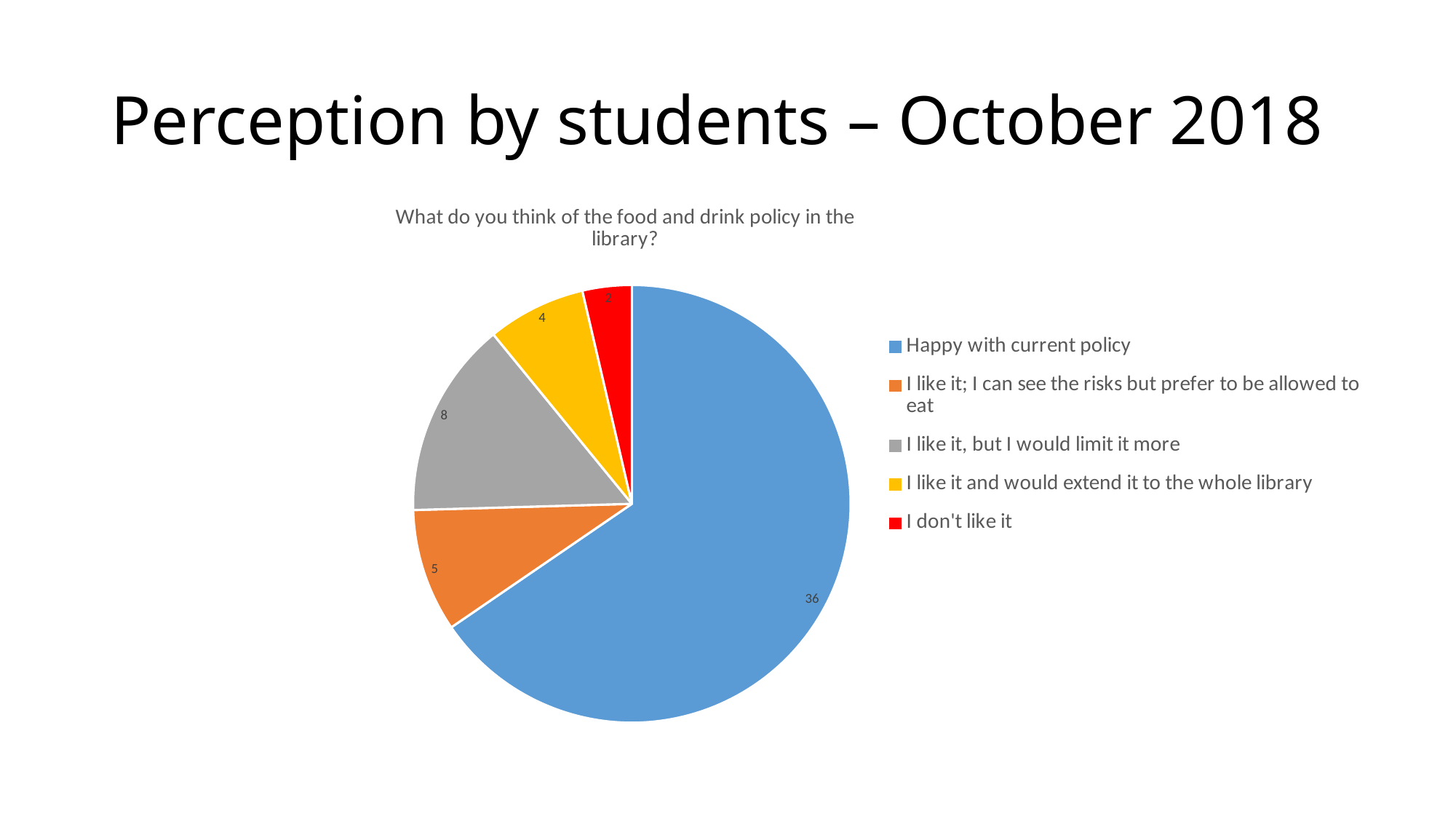
What is the value for "I like it, but I would limit it more"? 8 What is the difference between the values for "Happy with current policy" and "I like it, but I would limit it more"? 28 Which response has the smallest slice of the pie? I don't like it What type of chart is shown on the slide? Pie chart How many slices does the pie chart have? 5 What is the title of the pie chart? What do you think of the food and drink policy in the library? What is the total of all the values shown in the pie chart? 55 What is the value for "I don't like it"? 2 Which response has the largest slice of the pie? Happy with current policy Which is larger: the value for "I like it; I can see the risks but prefer to be allowed to eat" or the value for "I like it and would extend it to the whole library"? I like it; I can see the risks but prefer to be allowed to eat What is the value for "I like it and would extend it to the whole library"? 4 How many students answered "Happy with current policy"? 36